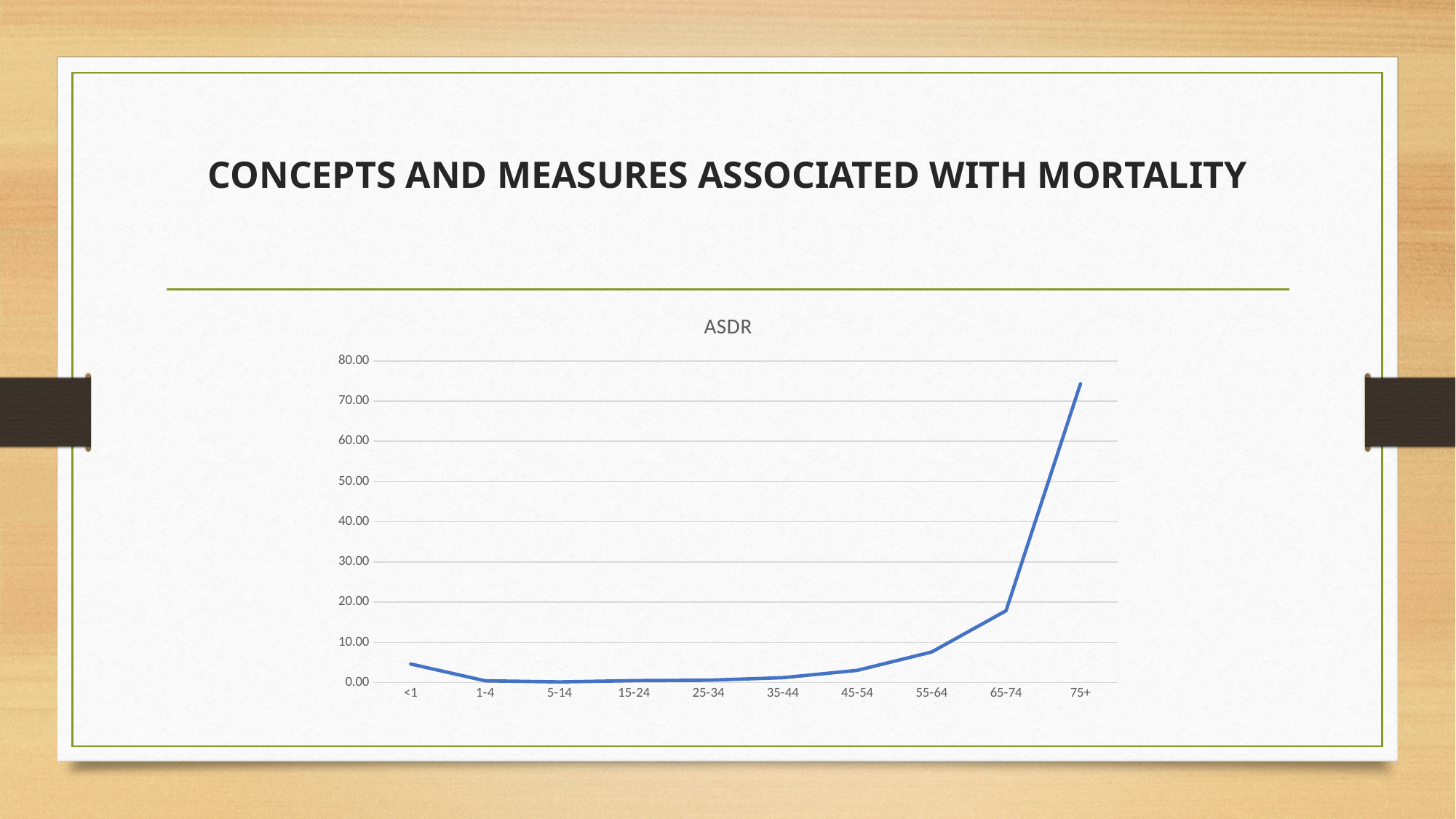
What kind of chart is shown on the slide? line chart What is the highest value shown on the y axis? 80.00 Does the line rise or fall between 55-64 and 75+? rise Is the value for <1 greater or less than 10.00? less How many age-group categories are plotted on the x axis? 10 Is the value for 55-64 greater or less than 10.00? less Which is larger, the value for <1 or the value for 1-4? <1 What is the title of the chart? ASDR Is the value for 65-74 greater or less than 20.00? less Which age group has the highest ASDR value? 75+ Which is larger, the value for 65-74 or the value for 75+? 75+